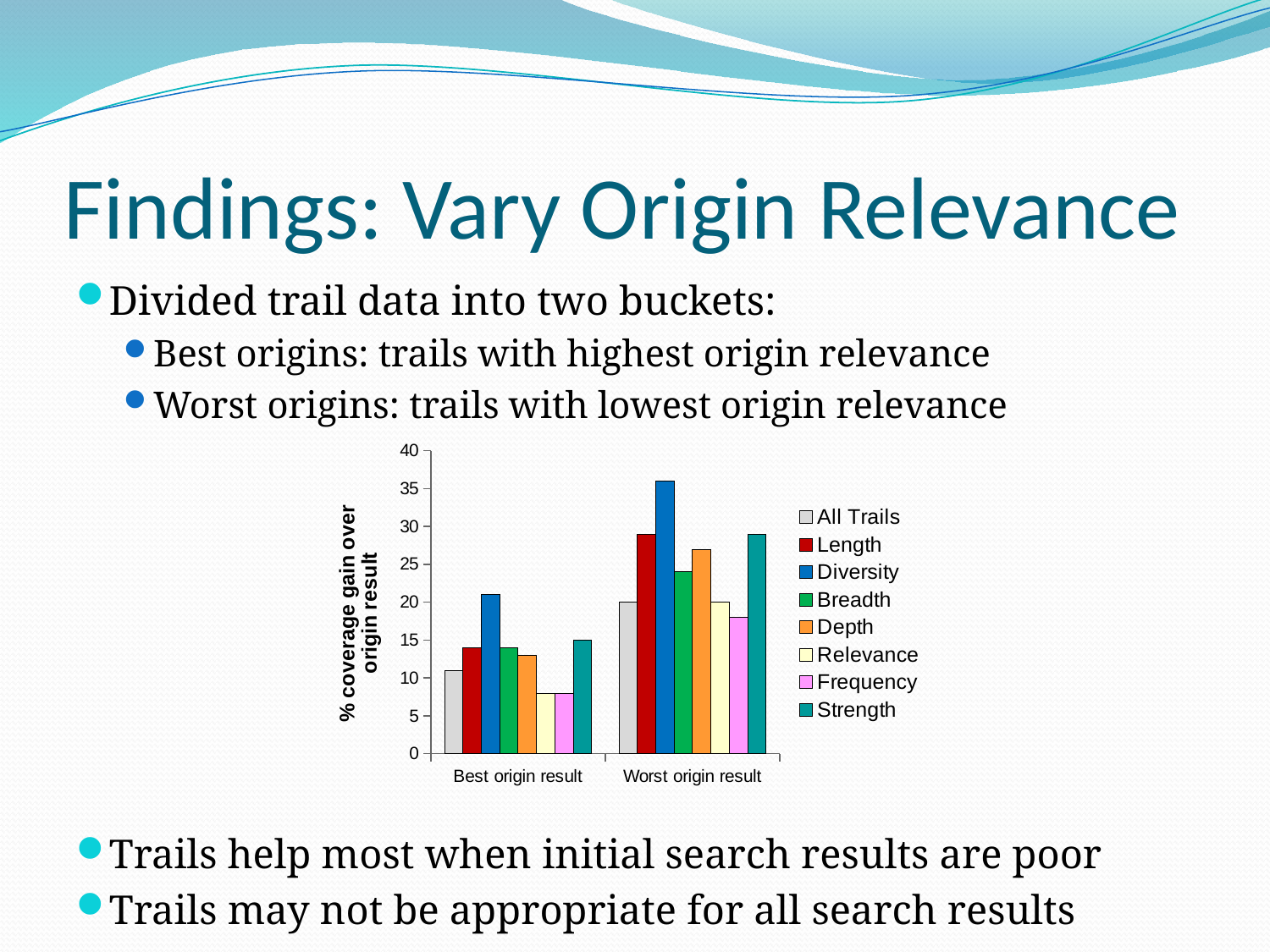
Which is larger: All Trails for Best origin result or All Trails for Worst origin result? Worst origin result What kind of chart is shown on the slide? bar chart Is the value for Diversity in Worst origin result greater or less than 30? greater Is the value for Strength in Worst origin result greater or less than 25? greater Which series has the highest value for Best origin result? Diversity Which is larger: Diversity or Length for Worst origin result? Diversity How many series does the legend list? 8 Which series has the highest value for Worst origin result? Diversity How many categories are shown on the x axis? 2 Is the value for Frequency in Best origin result greater or less than 10? less What is the label of the y axis? % coverage gain over origin result